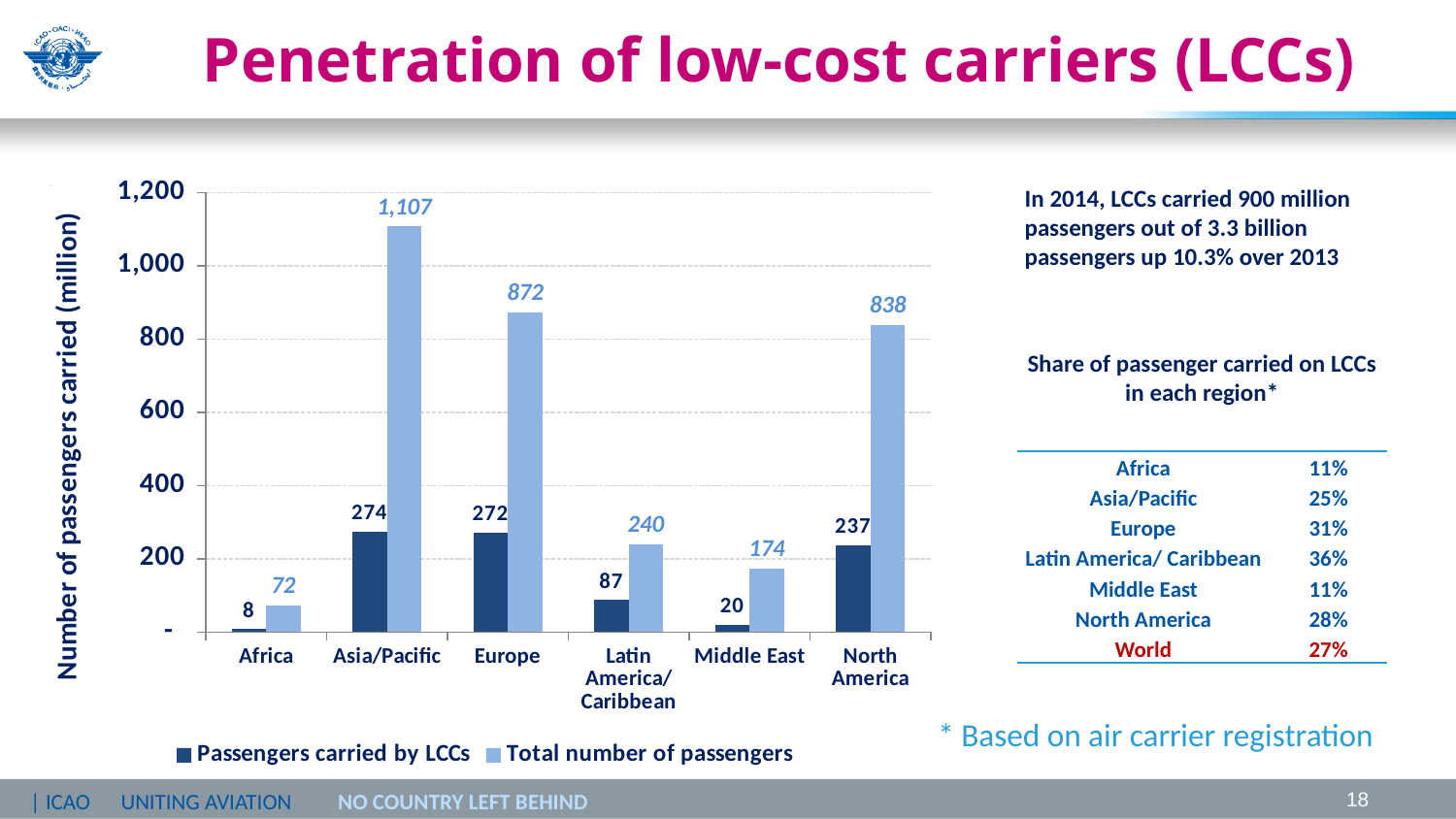
Is the total number of passengers for North America greater or less than 800? greater How many regions are shown on the x axis of the chart? 6 What is the number of passengers carried by LCCs in Asia/Pacific? 274 What is the number of passengers carried by LCCs in the Middle East? 20 Which region has the highest total number of passengers? Asia/Pacific What is the total number of passengers for Europe? 872 How many series does the chart legend list? 2 Which is larger: the total number of passengers for Latin America/Caribbean or for the Middle East? Latin America/Caribbean Which region has the lowest number of passengers carried by LCCs? Africa What is the difference between the total number of passengers and the passengers carried by LCCs in North America? 601 What kind of chart is shown on the slide? Bar chart What is the label of the vertical axis of the chart? Number of passengers carried (million)